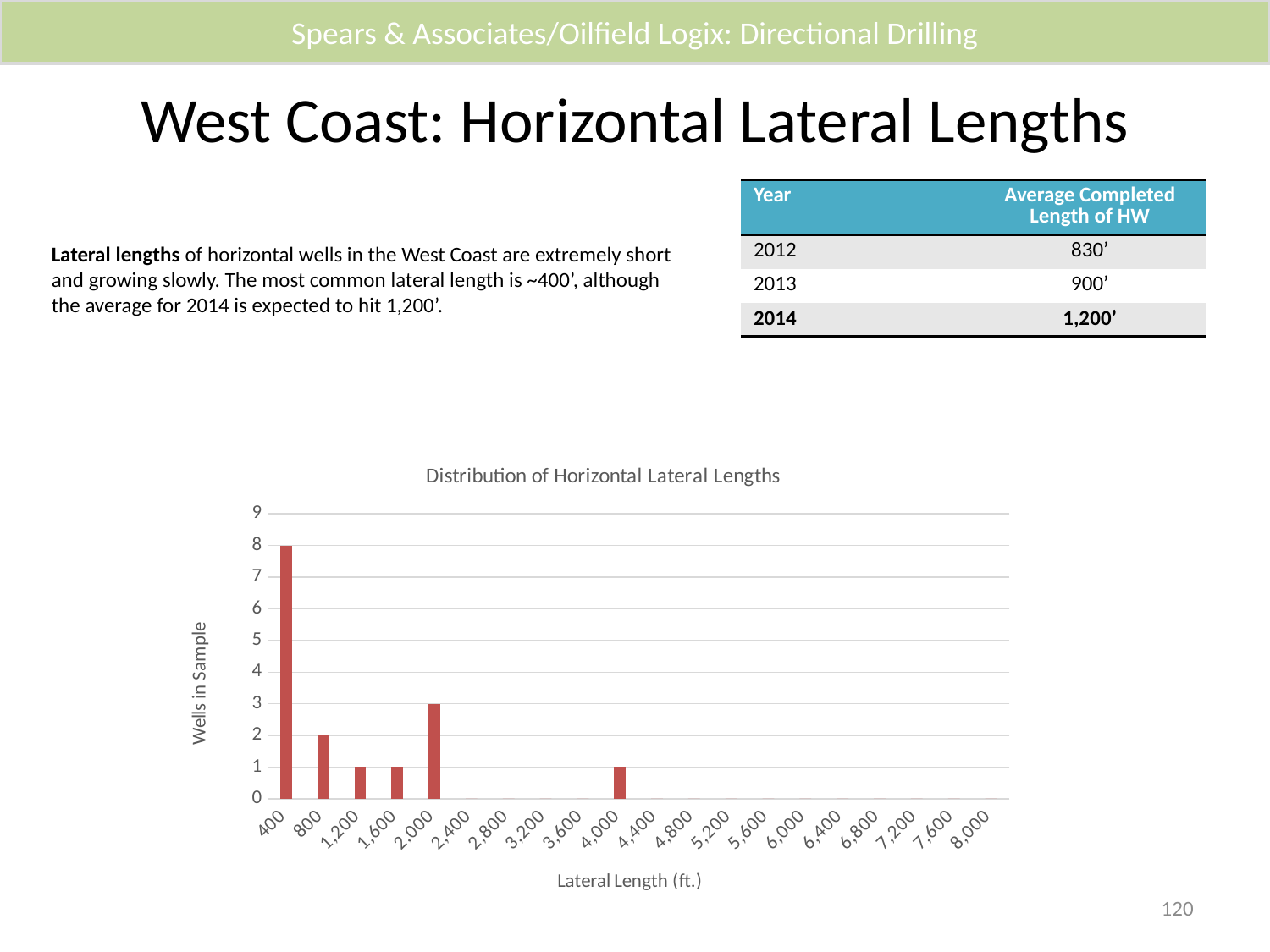
In the Distribution of Horizontal Lateral Lengths chart, how many wells in the sample have a lateral length of 2,000 ft? 3 What kind of chart is the Distribution of Horizontal Lateral Lengths chart? bar chart In the Distribution of Horizontal Lateral Lengths chart, how many wells in the sample have a lateral length of 4,000 ft? 1 In the Distribution of Horizontal Lateral Lengths chart, which has more wells in the sample: 800 ft or 2,000 ft? 2,000 How many lateral length categories in the Distribution of Horizontal Lateral Lengths chart have at least one well in the sample? 6 In the Distribution of Horizontal Lateral Lengths chart, is the number of wells at 400 ft greater or less than 5? greater In the Distribution of Horizontal Lateral Lengths chart, how many wells in the sample have a lateral length of 400 ft? 8 In the Distribution of Horizontal Lateral Lengths chart, which lateral length has the most wells in the sample? 400 How many lateral length categories are shown on the x axis of the Distribution of Horizontal Lateral Lengths chart? 20 What is the y-axis title of the Distribution of Horizontal Lateral Lengths chart? Wells in Sample In the Distribution of Horizontal Lateral Lengths chart, what is the difference between the number of wells at 400 ft and at 2,000 ft? 5 In the Distribution of Horizontal Lateral Lengths chart, how many wells in the sample have a lateral length of 800 ft? 2